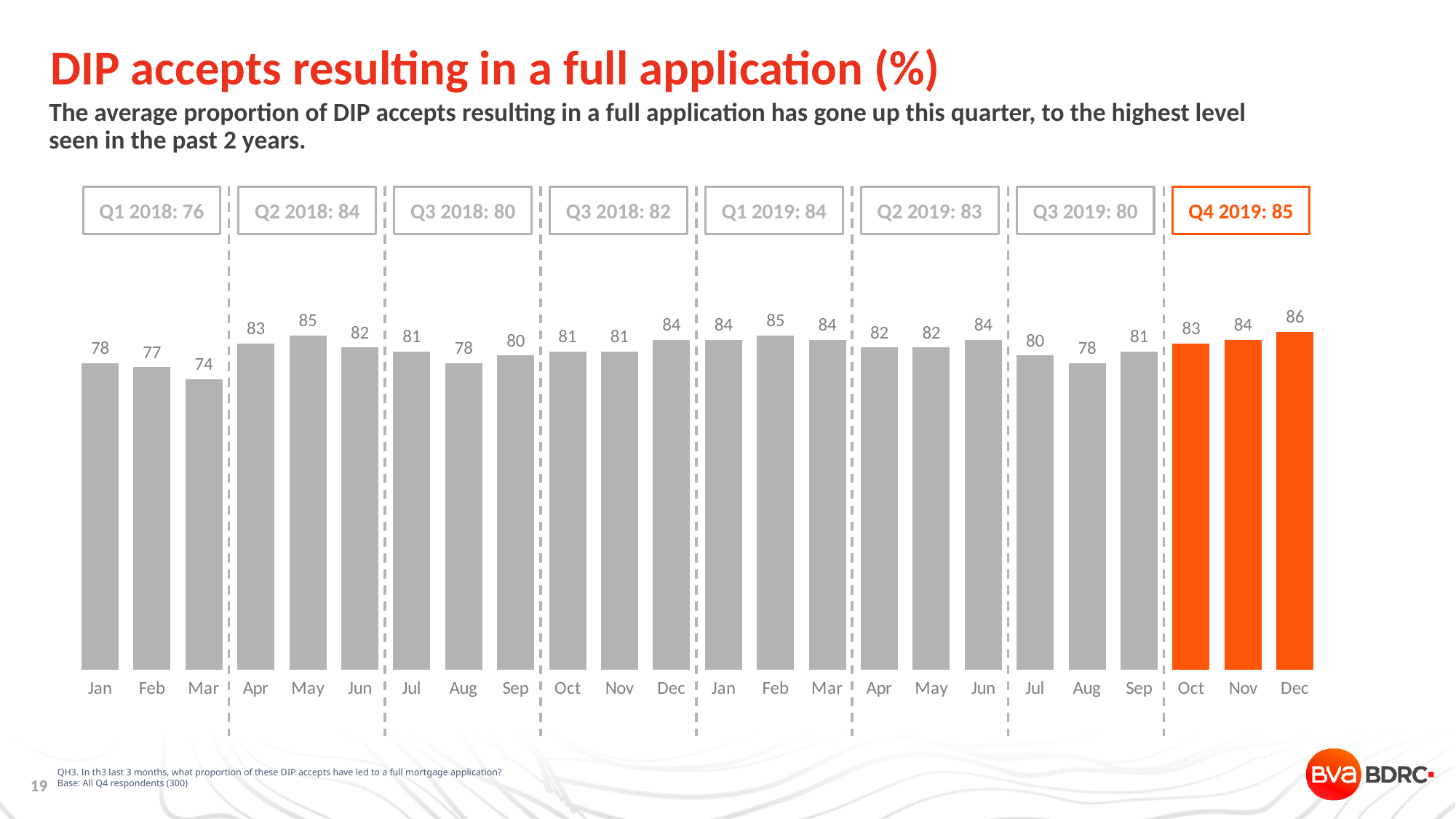
What type of chart is shown on the slide? bar chart Do the values rise or fall across the three months of Q4 2019 (Oct to Dec)? rise Which is larger, the value for Aug 2019 or the value for Oct 2019? Oct 2019 Which month has the lowest value in the chart? Mar 2018 What is the value for May 2018 (in Q2 2018)? 85 How many monthly bars are plotted in the chart? 24 Which month has the highest value in the chart? Dec 2019 What is the quarterly average shown in the box for Q4 2019? 85 What is the value for Dec 2019 (the last bar, in Q4 2019)? 86 What is the quarterly average shown in the box for Q1 2018? 76 What is the difference between the Dec 2019 value and the Mar 2018 value? 12 What is the value for Mar 2018 (the third bar, in Q1 2018)? 74